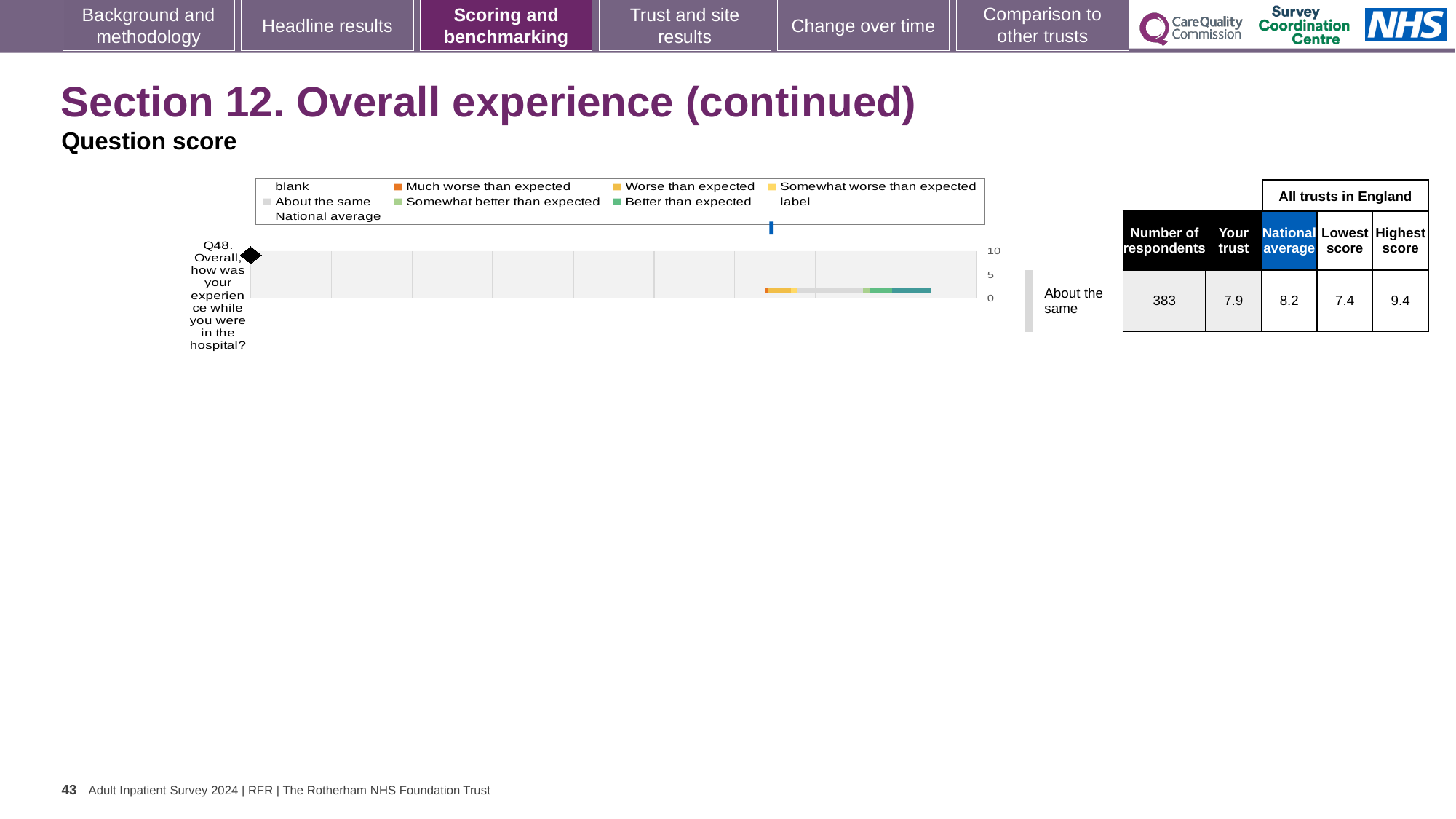
Which benchmarking category is the trust's Q48 result placed in? About the same What kind of chart is shown on the slide? bar chart How many survey questions are plotted on the chart? 1 Which is larger for Q48: the 'Your trust' score or the national average? National average What is the difference between the highest score and the lowest score for Q48? 2.0 What is the national average score for Q48? 8.2 What is the maximum value shown on the chart's score axis? 10 How many respondents answered Q48? 383 What is the lowest score among all trusts in England for Q48? 7.4 What is the difference between the national average and the 'Your trust' score for Q48? 0.3 What is the 'Your trust' score for Q48 (Overall, how was your experience while you were in the hospital?)? 7.9 What is the highest score among all trusts in England for Q48? 9.4